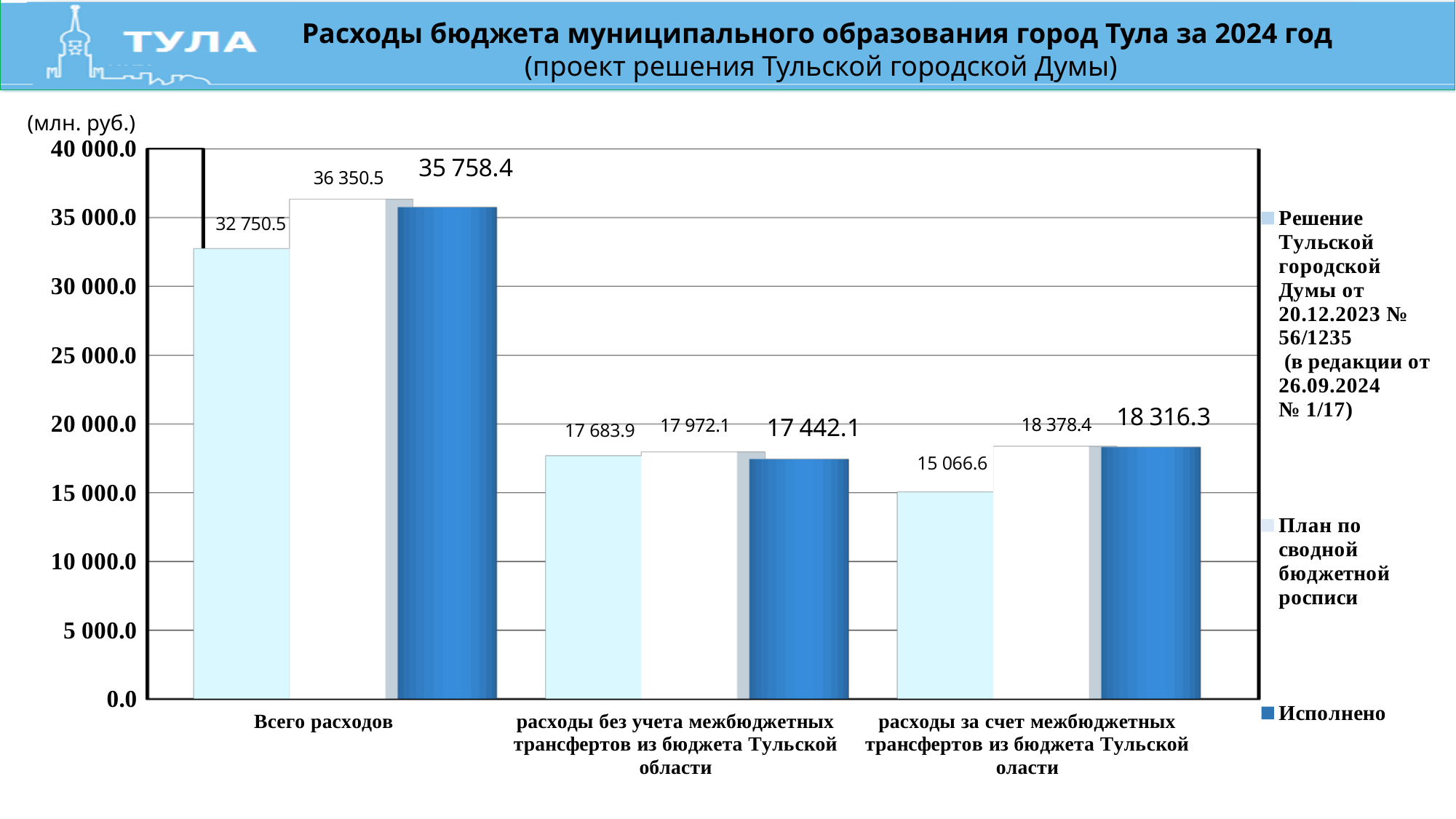
What is the value of "Исполнено" for "расходы без учета межбюджетных трансфертов из бюджета Тульской области"? 17 442.1 Which category has the highest "Исполнено" value? Всего расходов What is the value of "План по сводной бюджетной росписи" for "Всего расходов"? 36 350.5 How many categories are shown on the x axis? 3 For "расходы за счет межбюджетных трансфертов из бюджета Тульской оласти", which is larger: the "План по сводной бюджетной росписи" value or the "Решение Тульской городской Думы" value? План по сводной бюджетной росписи What kind of chart is shown on the slide? bar chart What is the value of "Исполнено" for "Всего расходов"? 35 758.4 Is the "Исполнено" value for "Всего расходов" greater or less than 35 000.0? greater Which category has the lowest value in the "Решение Тульской городской Думы" series? расходы за счет межбюджетных трансфертов из бюджета Тульской оласти How many series does the legend list? 3 What is the value of the "Решение Тульской городской Думы" series for "расходы за счет межбюджетных трансфертов из бюджета Тульской оласти"? 15 066.6 What is the difference between the "План по сводной бюджетной росписи" and "Исполнено" values for "Всего расходов"? 592.1